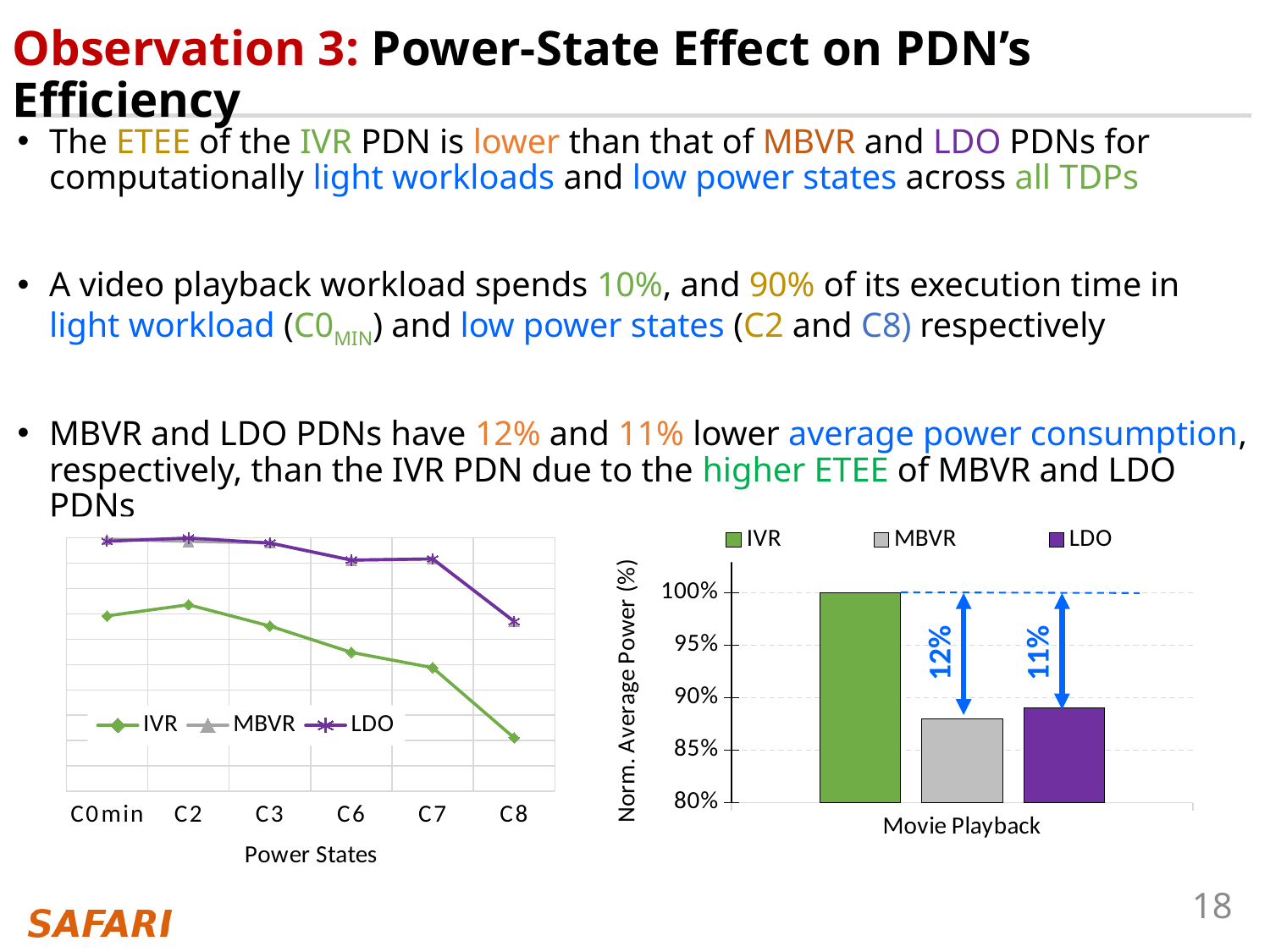
In the left chart (Power States), how many series does the legend list? 3 In the right chart (Norm. Average Power), what kind of chart is it? bar chart In the right chart (Norm. Average Power), which is larger, IVR or MBVR? IVR In the left chart (Power States), at which power state is the IVR series lowest? C8 In the right chart (Norm. Average Power), what is the value for IVR? 100% In the left chart (Power States), what kind of chart is it? line chart In the left chart (Power States), at which power state is the IVR series highest? C2 In the left chart (Power States), how many power states are shown on the x axis? 6 In the right chart (Norm. Average Power), is the value for MBVR greater or less than 90%? less In the right chart (Norm. Average Power), what is the label on the x axis category? Movie Playback In the left chart (Power States), does the IVR series rise or fall from C2 to C8? fall In the left chart (Power States), which series is higher at C8, IVR or LDO? LDO